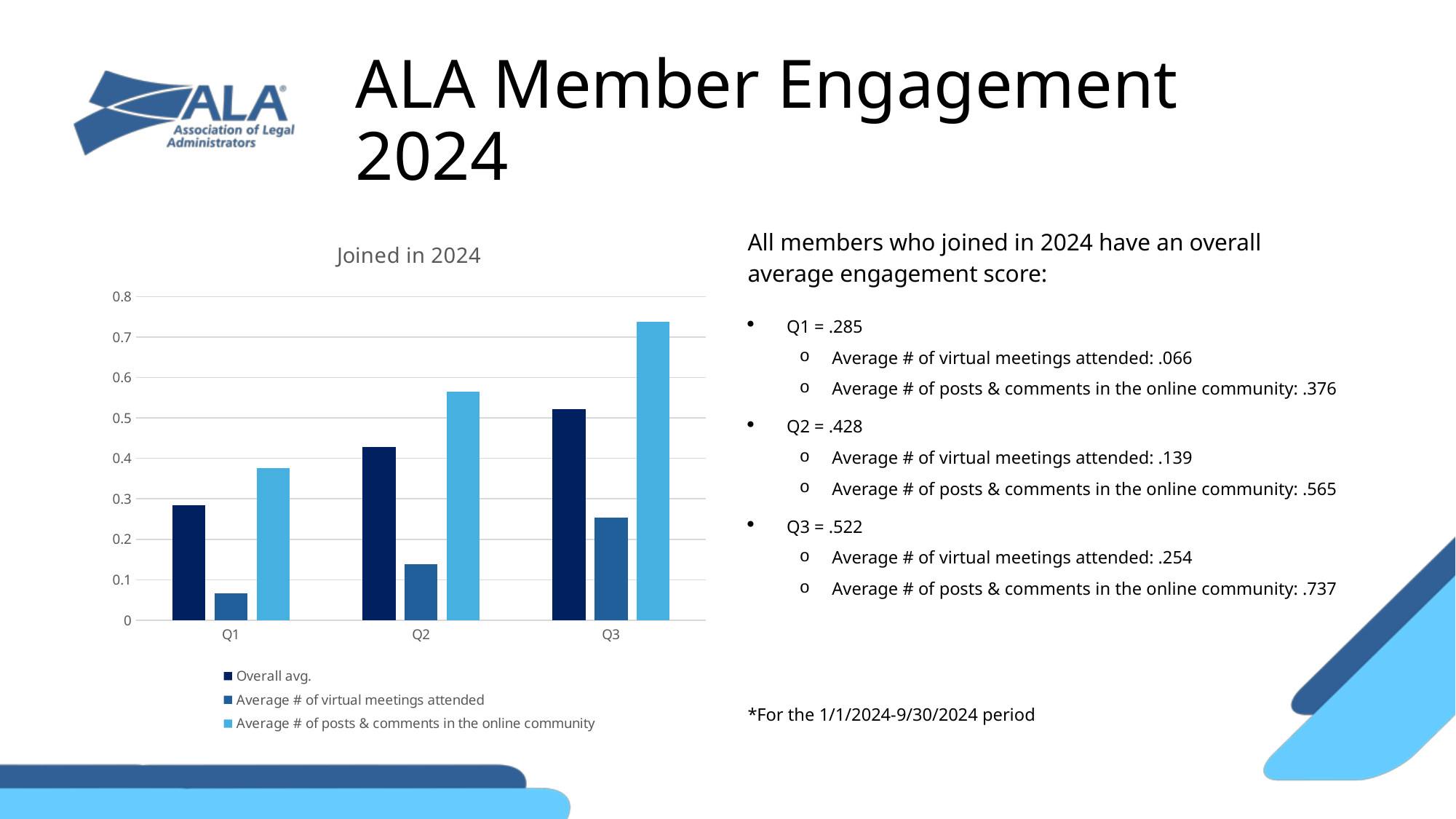
Does the overall average engagement score rise or fall from Q1 to Q3? rise What is the overall average engagement score for Q2? .428 What kind of chart is shown on the slide? bar chart What is the difference between the overall average engagement score for Q3 and Q1? .237 Which quarter has the lowest average number of virtual meetings attended? Q1 How many quarters are shown on the x axis of the chart? 3 What is the title of the chart? Joined in 2024 Which quarter has the highest overall average engagement score? Q3 What is the average number of virtual meetings attended for Q1? .066 How many series does the chart legend list? 3 What is the average number of posts & comments in the online community for Q3? .737 Is the value for average # of posts & comments in the online community in Q3 greater or less than 0.7? greater